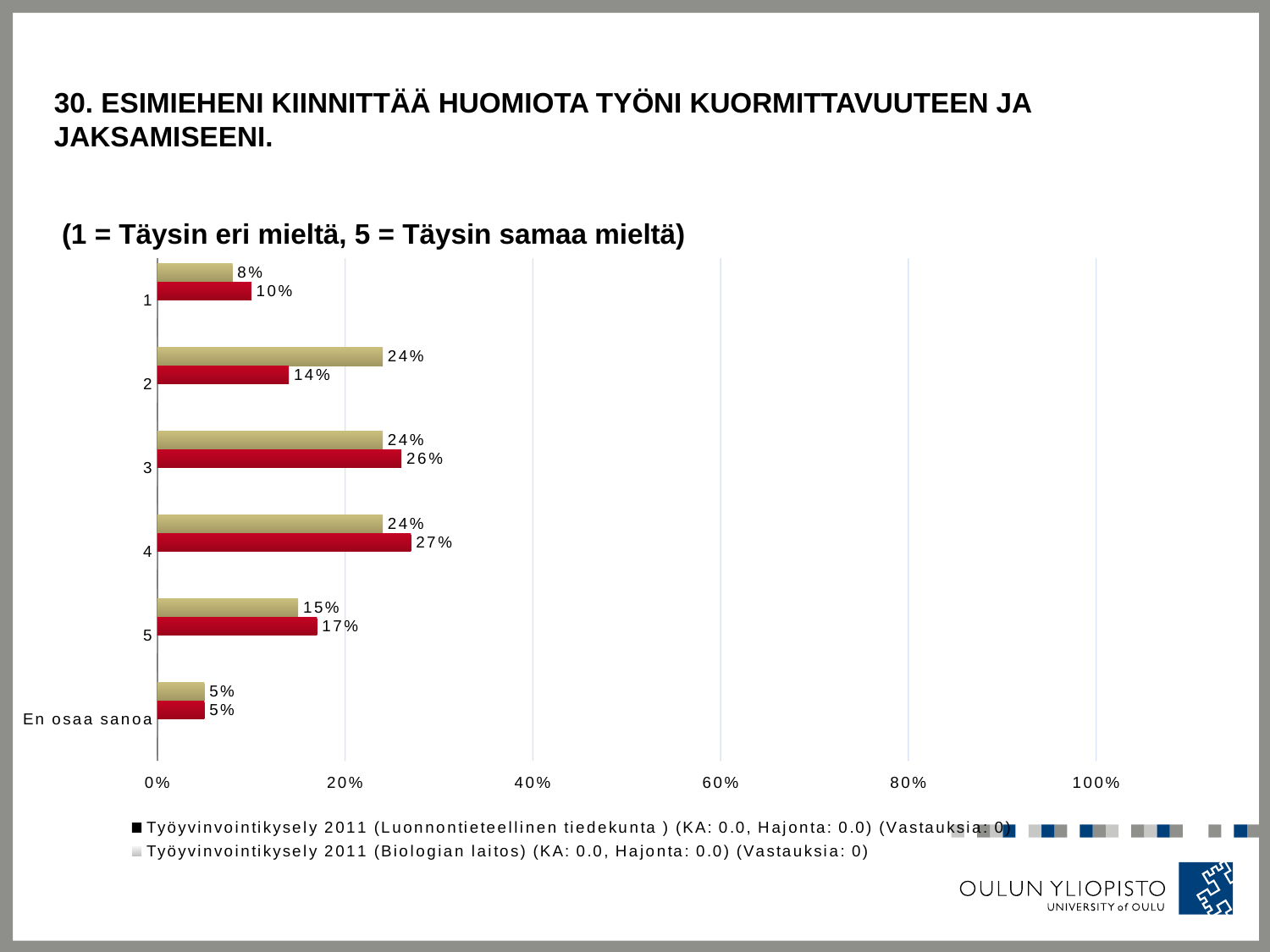
What is the value of the red bar for "En osaa sanoa"? 5% What is the highest tick label on the horizontal axis? 100% Is the value of the red bar for category 4 greater or less than 20%? greater How many categories are shown on the vertical axis? 6 How many series does the legend list? 2 For category 3, which is larger: the red bar or the tan bar? the red bar What is the value of the red bar for category 4? 27% What is the difference between the tan bar and the red bar for category 2? 10 percentage points What is the value of the tan bar for category 2? 24% What kind of chart is shown on the slide? bar chart Which category has the lowest tan bar? En osaa sanoa Which category has the highest red bar? 4